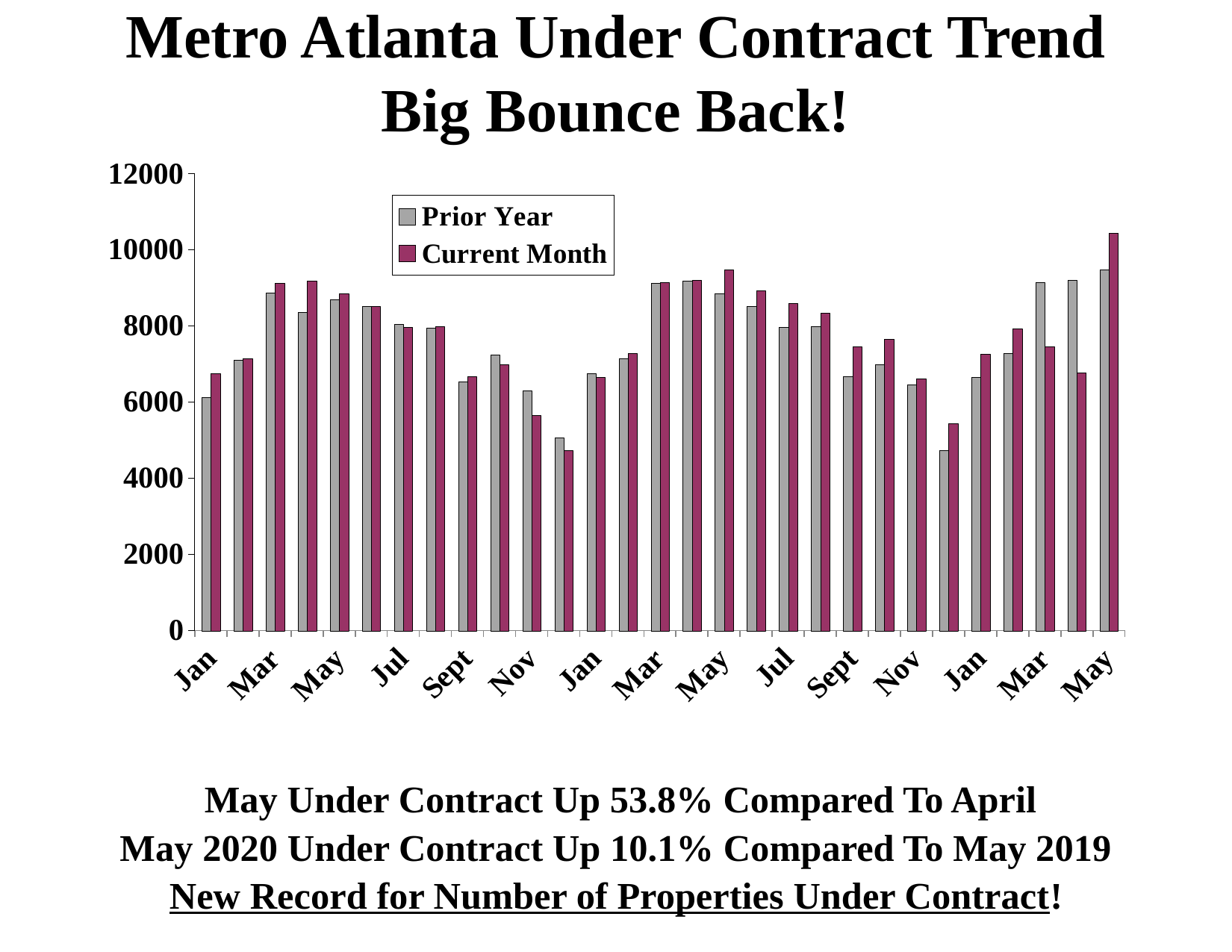
For the rightmost May, which is larger, the Prior Year bar or the Current Month bar? Current Month How many series does the legend list? 2 Is the Prior Year value for the rightmost Jan greater or less than 6000? greater Is the Current Month value for the leftmost Nov greater or less than 6000? less Which month has the highest Current Month bar? The rightmost May What is the title of the chart? Metro Atlanta Under Contract Trend Big Bounce Back! For the rightmost Mar, which is larger, the Prior Year bar or the Current Month bar? Prior Year What kind of chart is shown on the slide? Bar chart What are the two series named in the legend? Prior Year and Current Month Is the Current Month value for the rightmost May greater or less than 10000? greater